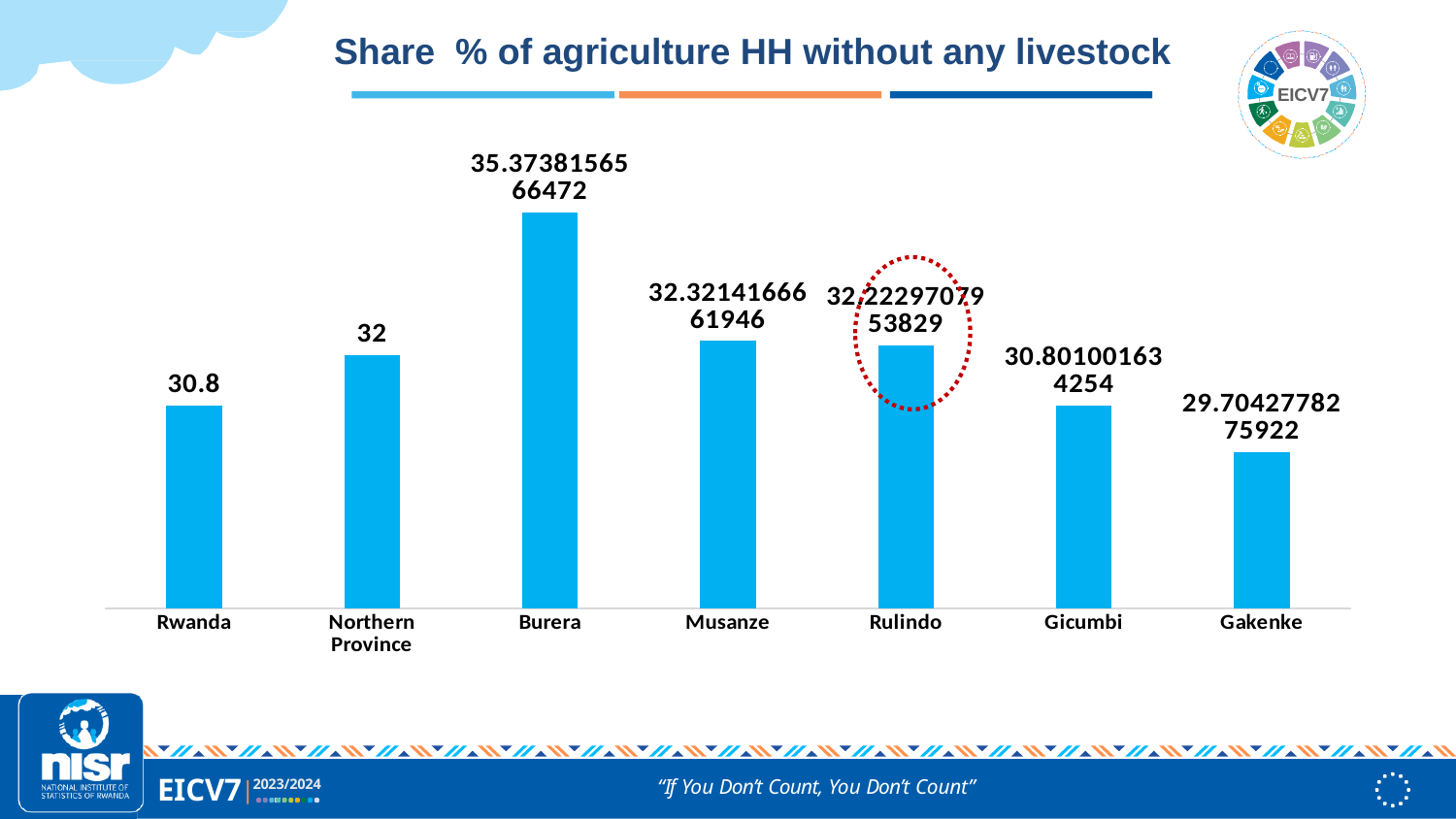
Which category has the highest value? Burera What is the value shown for Burera? 35.3738156566472 What kind of chart is shown on the slide? Bar chart What is the difference between the values for Northern Province and Rwanda? 1.2 Which is larger, the value for Gicumbi or the value for Gakenke? Gicumbi Which category's data label is highlighted with a red dotted circle? Rulindo What is the value for Northern Province? 32 What is the title of the chart? Share % of agriculture HH without any livestock What is the value for Rwanda? 30.8 Which is larger, the value for Burera or the value for Musanze? Burera Which category has the lowest value? Gakenke How many categories are shown on the x axis? 7